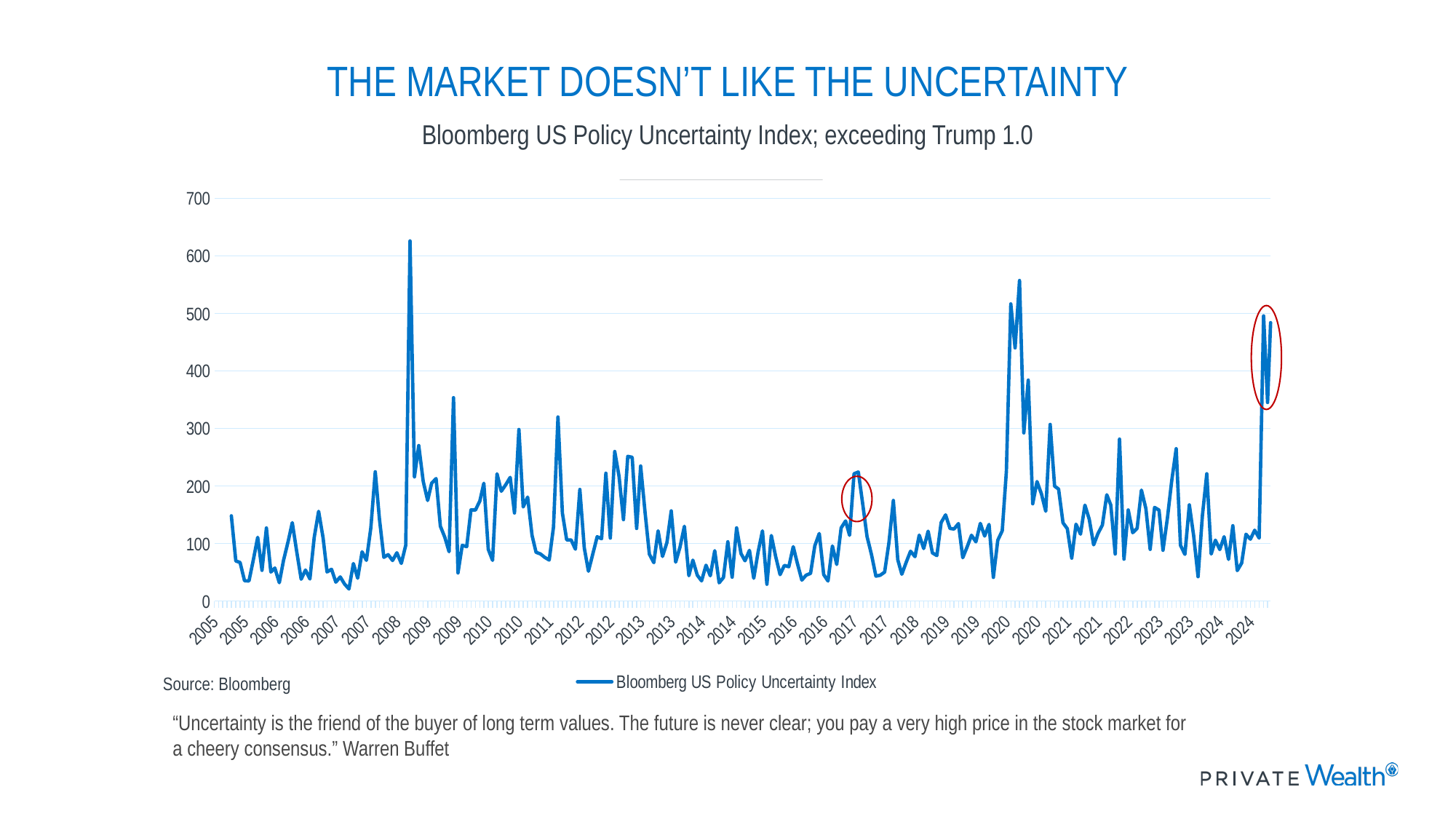
Is the circled peak of the index in 2017 greater or less than 300? less Is the peak of the index in 2020 greater or less than 600? less What kind of chart is shown on the slide? line chart How many series does the legend list? 1 In which year does the Bloomberg US Policy Uncertainty Index reach its highest peak? 2008 Which is higher, the peak of the index in 2008 or the peak in 2020? 2008 What is the name of the series shown in the legend? Bloomberg US Policy Uncertainty Index Is the peak of the index in 2020 greater or less than 500? greater Which is higher, the circled peak in 2024 or the circled peak in 2017? 2024 How many red circles are drawn on the chart? 2